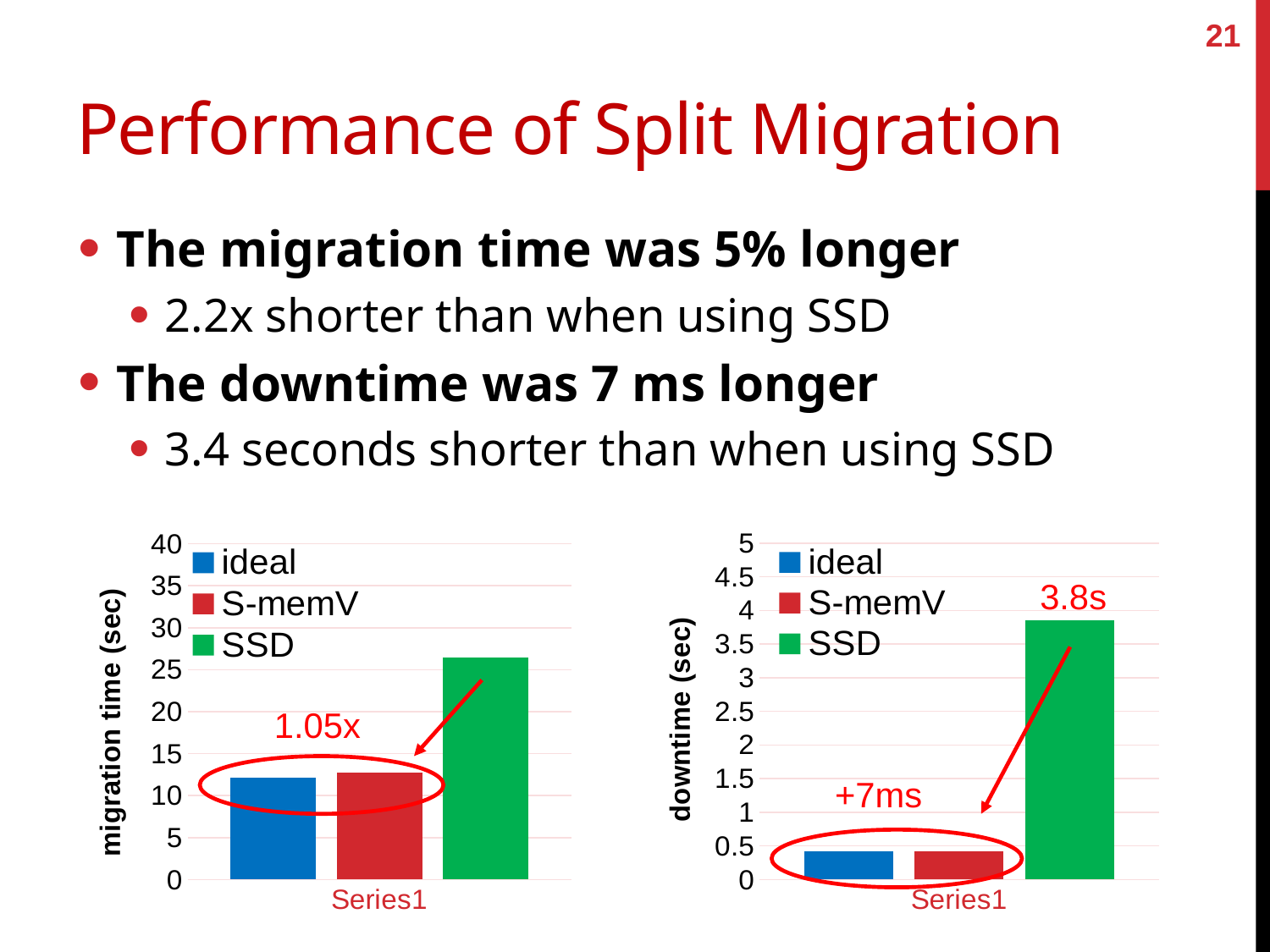
How many series does the legend of the right chart (downtime) list? 3 What kind of chart is the left chart (migration time)? bar chart In the right chart (downtime), which is larger: the downtime for SSD or for ideal? SSD In the left chart (migration time), what ratio annotation is written above the circled ideal and S-memV bars? 1.05x In the left chart (migration time), is the migration time for ideal greater or less than 15? less In the right chart (downtime), is the downtime for ideal greater or less than 1? less In the left chart (migration time), which is larger: the migration time for SSD or for S-memV? SSD In the left chart (migration time), which series has the highest migration time? SSD In the right chart (downtime), what downtime value is labelled for the SSD bar? 3.8s In the left chart (migration time), is the migration time for SSD greater or less than 25? greater What is the y-axis label of the left chart? migration time (sec) In the right chart (downtime), which series has the highest downtime? SSD